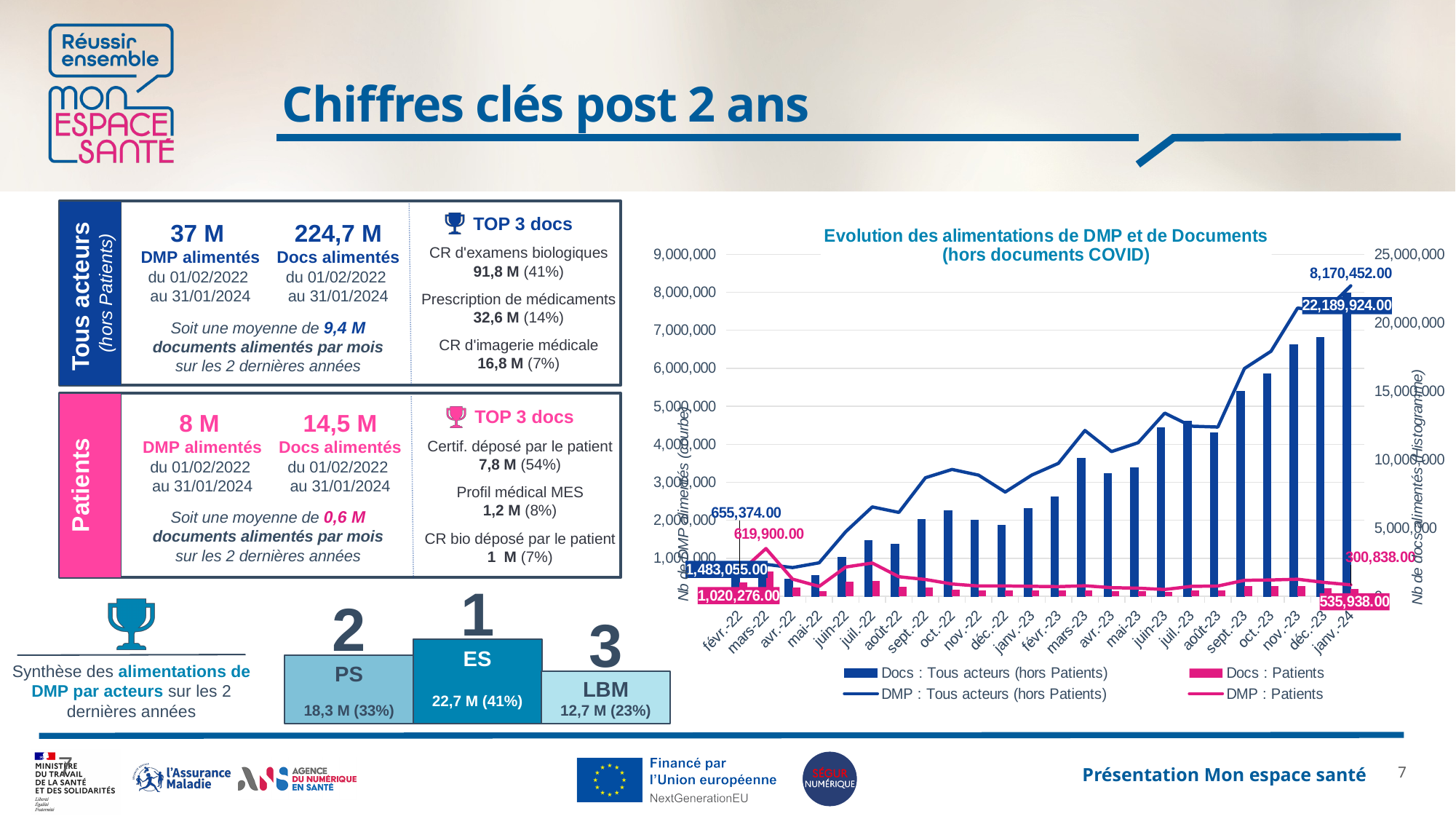
What is the labelled value of 'Docs : Patients' for janv.-24? 535,938.00 What is the title of the chart on the slide? Evolution des alimentations de DMP et de Documents (hors documents COVID) In which month is the 'Docs : Tous acteurs (hors Patients)' bar highest? janv.-24 What is the labelled value of 'DMP : Tous acteurs (hors Patients)' for janv.-24? 8,170,452.00 What is the labelled value of 'Docs : Tous acteurs (hors Patients)' for janv.-24? 22,189,924.00 What is the difference between the janv.-24 values of 'Docs : Tous acteurs (hors Patients)' and 'Docs : Patients'? 21,653,986.00 What is the labelled value of 'Docs : Tous acteurs (hors Patients)' for févr.-22? 1,483,055.00 Does the 'DMP : Tous acteurs (hors Patients)' line generally rise or fall from févr.-22 to janv.-24? Rise How many series does the chart legend list? 4 How many months are shown on the x axis of the chart? 24 What kind of chart is shown on the slide? Combined bar and line chart What is the labelled value of 'DMP : Patients' for janv.-24? 300,838.00